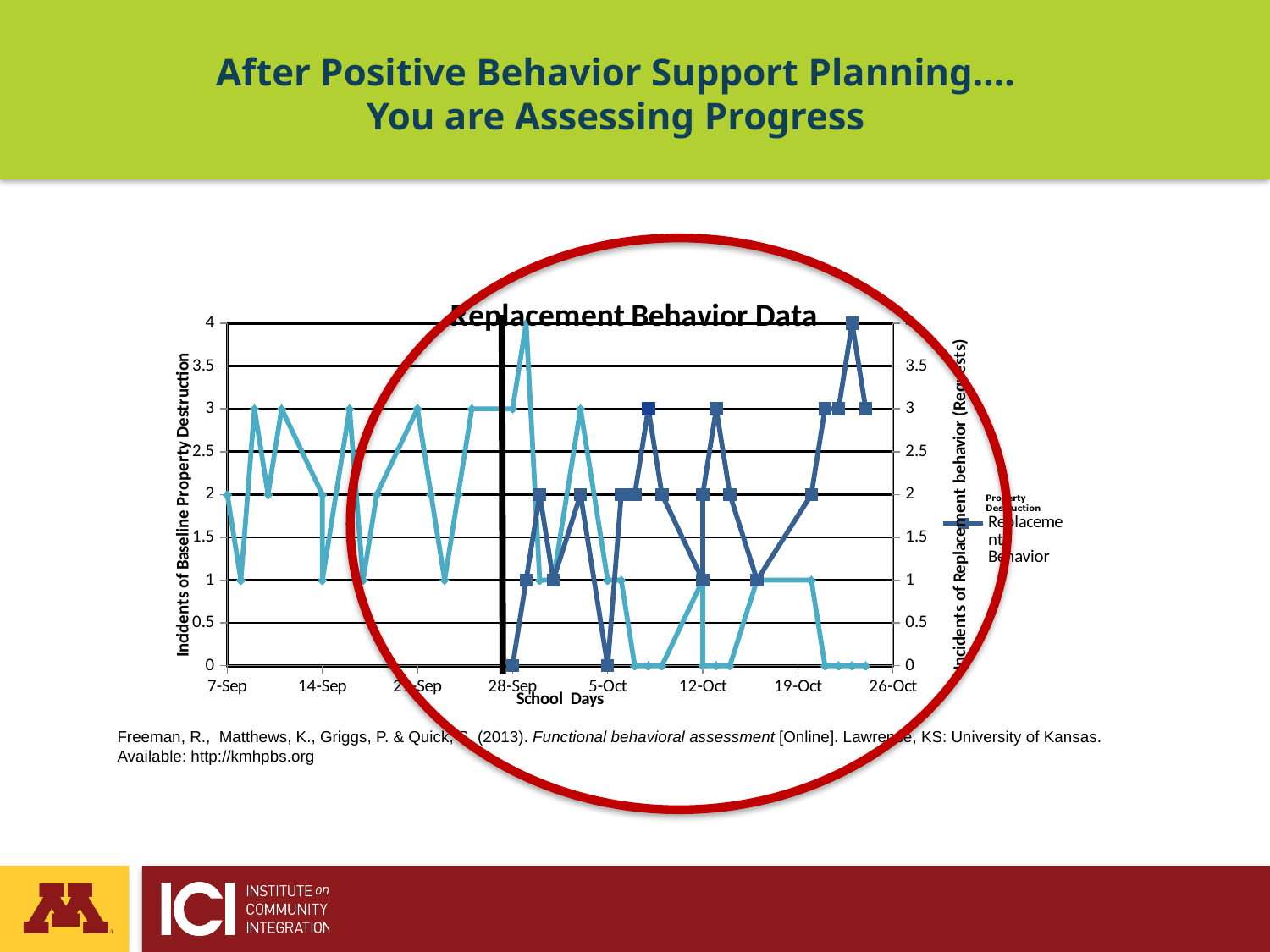
What are the two series named in the chart's legend? Property Destruction and Replacement Behavior What is the lowest value reached by the Replacement Behavior series? 0 At the last plotted points on the chart, which series is higher: Property Destruction or Replacement Behavior? Replacement Behavior Does the Replacement Behavior series generally rise or fall from 28-Sep to the end of the chart? rise What kind of chart is shown on the slide? line chart Does the Property Destruction series generally rise or fall from 28-Sep to the end of the chart? fall What is the highest value reached by the Replacement Behavior series? 4 How many series does the legend of the chart list? 2 Is the value of the Property Destruction series at its last plotted point greater or less than 0.5? less Is the value of the Replacement Behavior series at its last plotted point greater or less than 2? greater What is the highest value reached by the Property Destruction series? 4 What is the title of the chart? Replacement Behavior Data